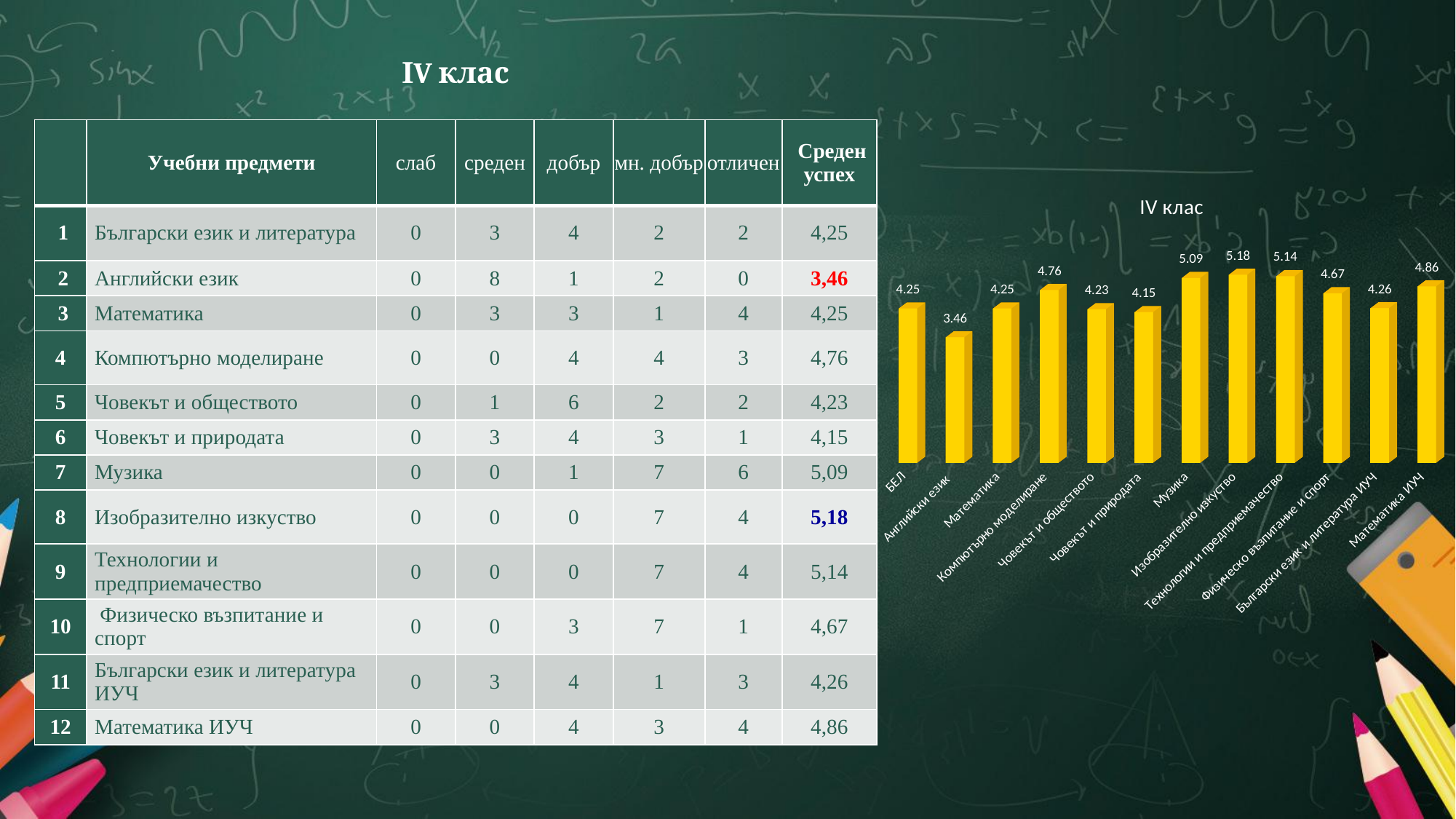
What type of chart is shown on the slide? bar chart Which category has the highest value in the chart? Изобразително изкуство What is the value for Математика ИУЧ in the chart? 4.86 What is the value for Английски език in the chart? 3.46 What is the value for Компютърно моделиране in the chart? 4.76 Which category has the lowest value in the chart? Английски език How many bars does the chart have? 12 Which is larger, the value for Физическо възпитание и спорт or the value for Човекът и природата? Физическо възпитание и спорт What is the value for Музика in the chart? 5.09 What is the title of the chart? IV клас What colour are the bars in the chart? yellow What is the difference between the values for Изобразително изкуство and Английски език? 1.72